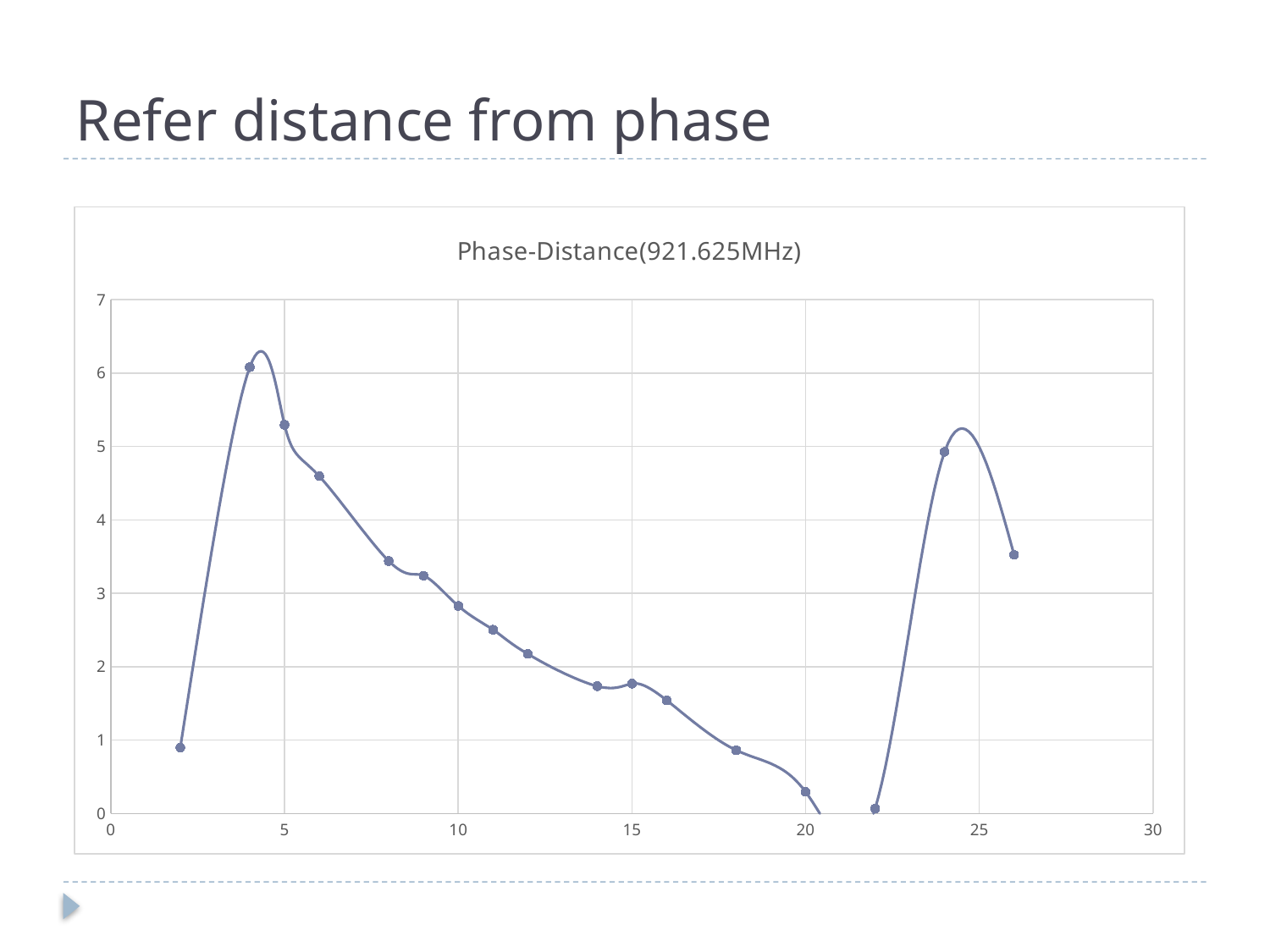
Is the value at x = 4 greater or less than 5? greater Which has the larger value, the point at x = 5 or the point at x = 6? x = 5 Which has the larger value, the point at x = 24 or the point at x = 26? x = 24 At which x value does the chart reach its lowest point? 22 Is the value at x = 24 greater or less than 4? greater At which x value does the chart reach its highest point? 4 Is the value at x = 20 greater or less than 1? less How many data points are plotted on the chart? 17 What kind of chart is shown on the slide? line chart What is the title of the chart? Phase-Distance(921.625MHz) Between x = 4 and x = 20, do the values rise or fall along the x axis? fall